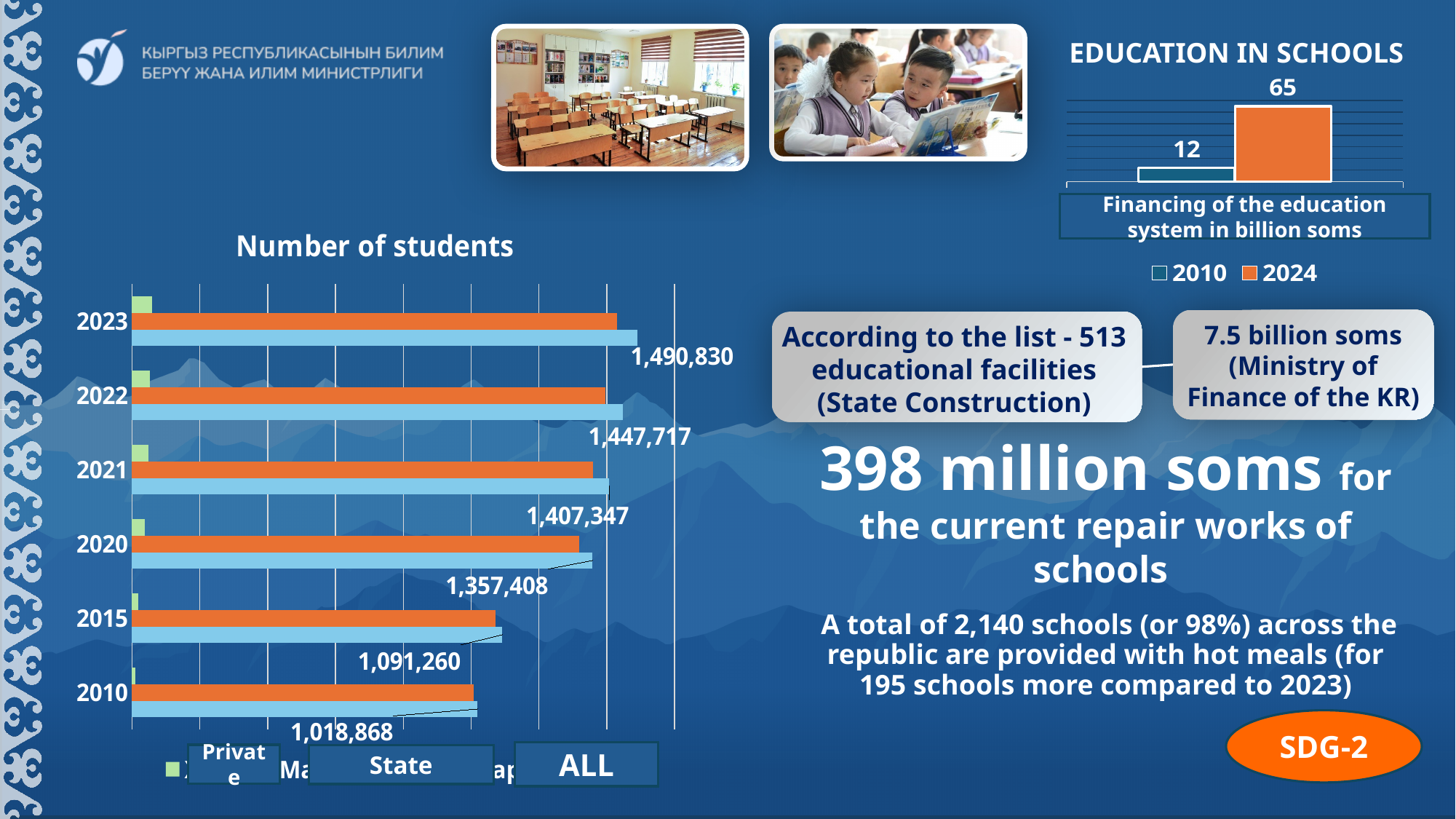
In the 'Number of students' chart, what is the ALL value for 2023? 1,490,830 In the 'Number of students' chart, how many years are shown? 6 In the 'Number of students' chart, how many series does the legend list? 3 In the 'Number of students' chart, what is the ALL value for 2010? 1,018,868 In the 'Financing of the education system in billion soms' chart, what is the difference between the 2024 and 2010 values? 53 In the 'Number of students' chart, what is the ALL value for 2020? 1,357,408 In the 'Number of students' chart, which year has the highest ALL value? 2023 In the 'Financing of the education system in billion soms' chart, what is the value for 2024? 65 What kind of chart is the 'Financing of the education system in billion soms' chart? bar chart In the 'Number of students' chart, do the ALL values rise or fall from 2010 to 2023? rise In the 'Number of students' chart, what is the difference between the ALL values for 2023 and 2022? 43,113 In the 'Number of students' chart, which year has the lowest ALL value? 2010